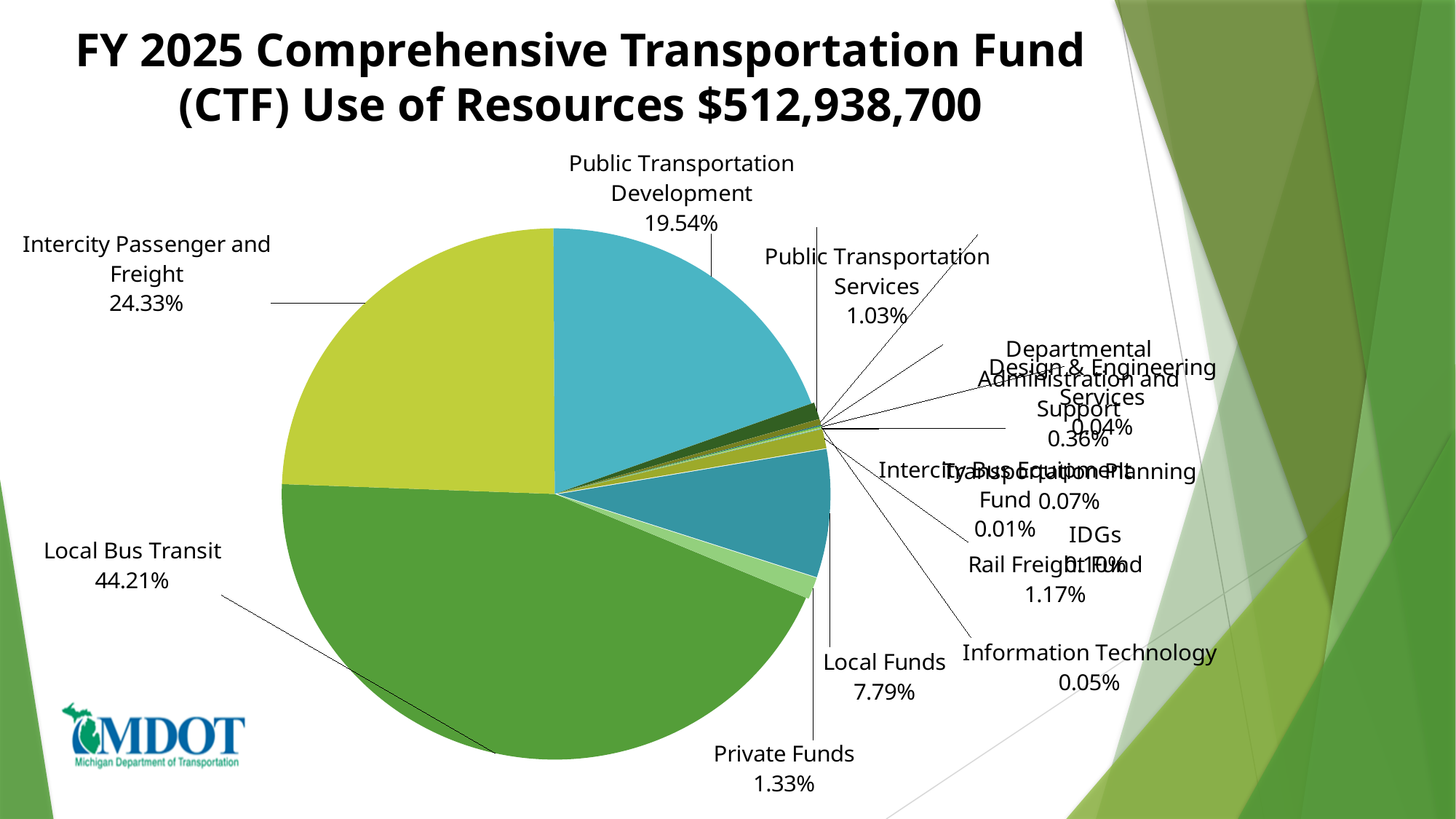
What kind of chart is shown on the slide? Pie chart What share of the pie is Local Funds? 7.79% What percentage is shown for Rail Freight Fund? 1.17% What total dollar amount is given in the chart title? $512,938,700 What share of the pie does Local Bus Transit represent? 44.21% What percentage is shown for Intercity Passenger and Freight? 24.33% What percentage is shown for Public Transportation Services? 1.03% How many percentage points larger is Local Bus Transit than Intercity Passenger and Freight? 19.88% Which is larger, the share for Local Funds or the share for Private Funds? Local Funds Which category has the largest share of the pie? Local Bus Transit What percentage is shown for Public Transportation Development? 19.54% What percentage is labelled for Private Funds? 1.33%